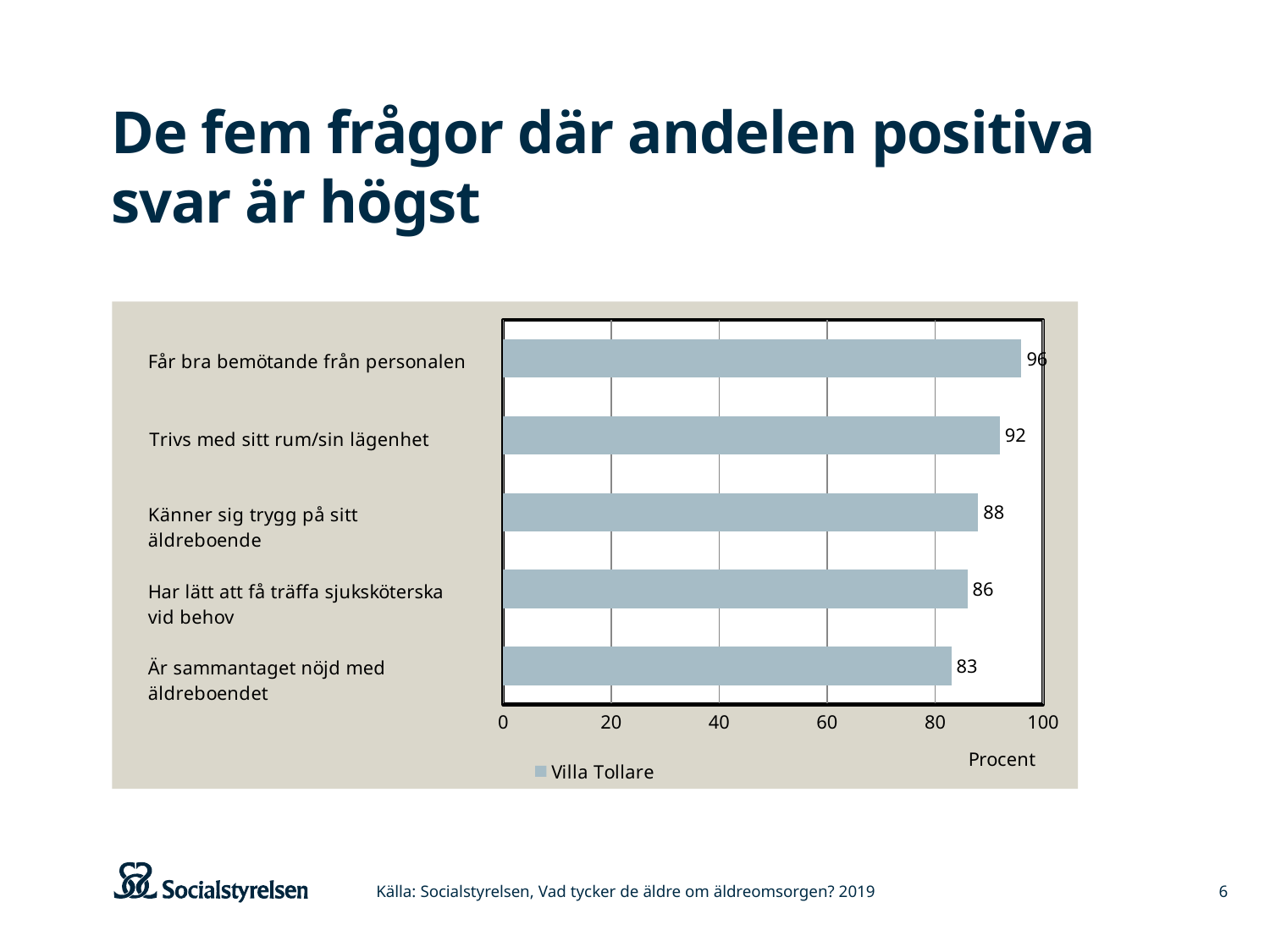
What kind of chart is shown on the slide? bar chart What is the difference between the values for "Får bra bemötande från personalen" and "Är sammantaget nöjd med äldreboendet"? 13 Which is larger: the value for "Har lätt att få träffa sjuksköterska vid behov" or the value for "Känner sig trygg på sitt äldreboende"? Känner sig trygg på sitt äldreboende What is the value for "Trivs med sitt rum/sin lägenhet"? 92 What is the value for "Känner sig trygg på sitt äldreboende"? 88 What series name is shown in the chart legend? Villa Tollare Is the value for "Trivs med sitt rum/sin lägenhet" greater or less than 80? greater Which category has the lowest value? Är sammantaget nöjd med äldreboendet What is the value for "Är sammantaget nöjd med äldreboendet"? 83 Which category has the highest value? Får bra bemötande från personalen What is the value for "Får bra bemötande från personalen"? 96 How many categories are shown in the chart? 5